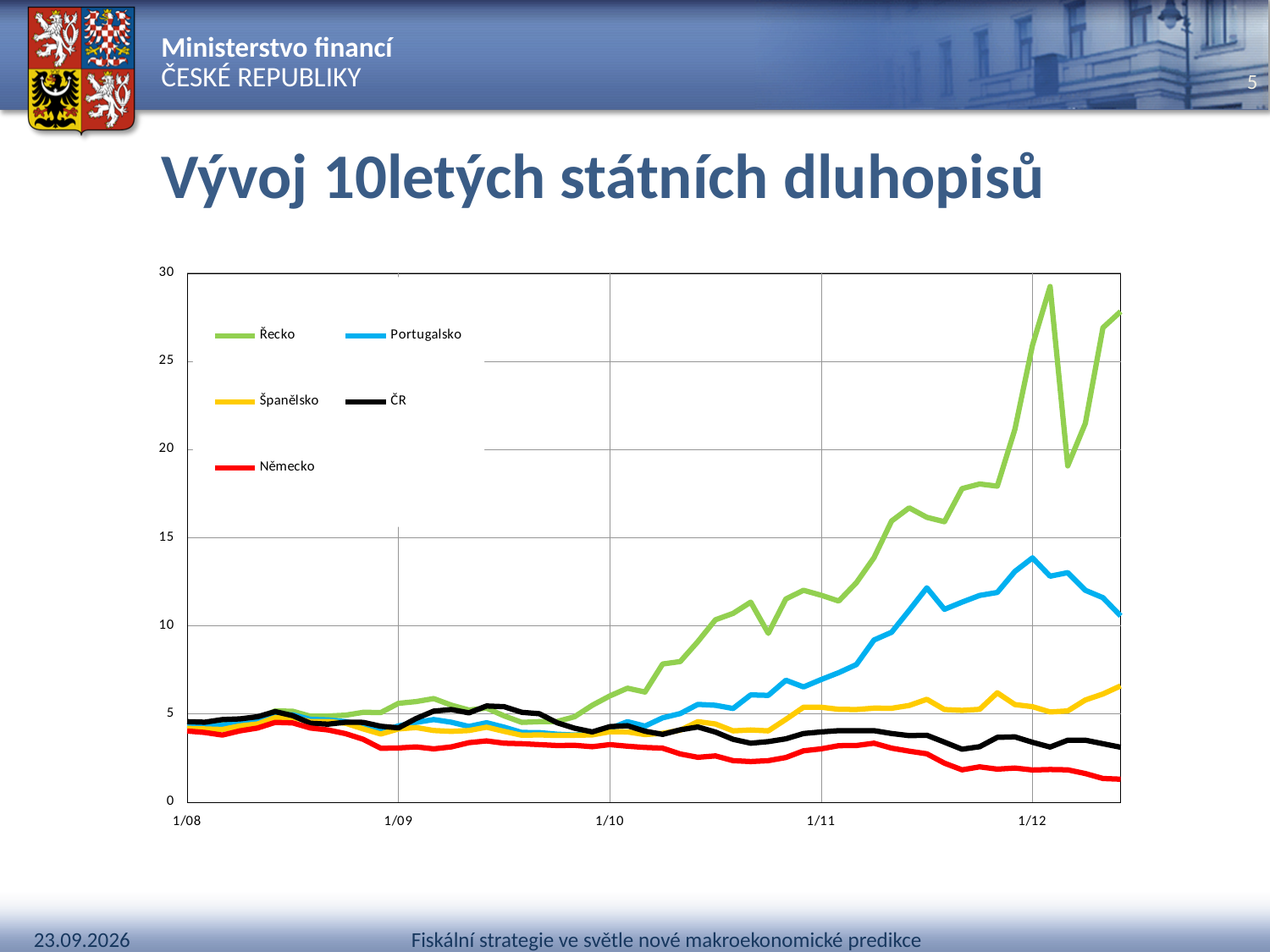
What colour is the line for ČR? black Is the value for Německo at 1/12 greater or less than 5? less Is the peak value for Řecko greater or less than 25? greater Is the value for Portugalsko at 1/11 greater or less than 5? greater Does the Německo series generally rise or fall between 1/11 and the end of the chart? fall How many series does the legend list? 5 Does the Řecko series generally rise or fall between 1/10 and 1/12? rise Which series reaches the highest value on the chart? Řecko What kind of chart is shown on the slide? line chart At 1/12, which is larger: the value for Řecko or the value for Portugalsko? Řecko Which series has the lowest value at the right end of the chart? Německo